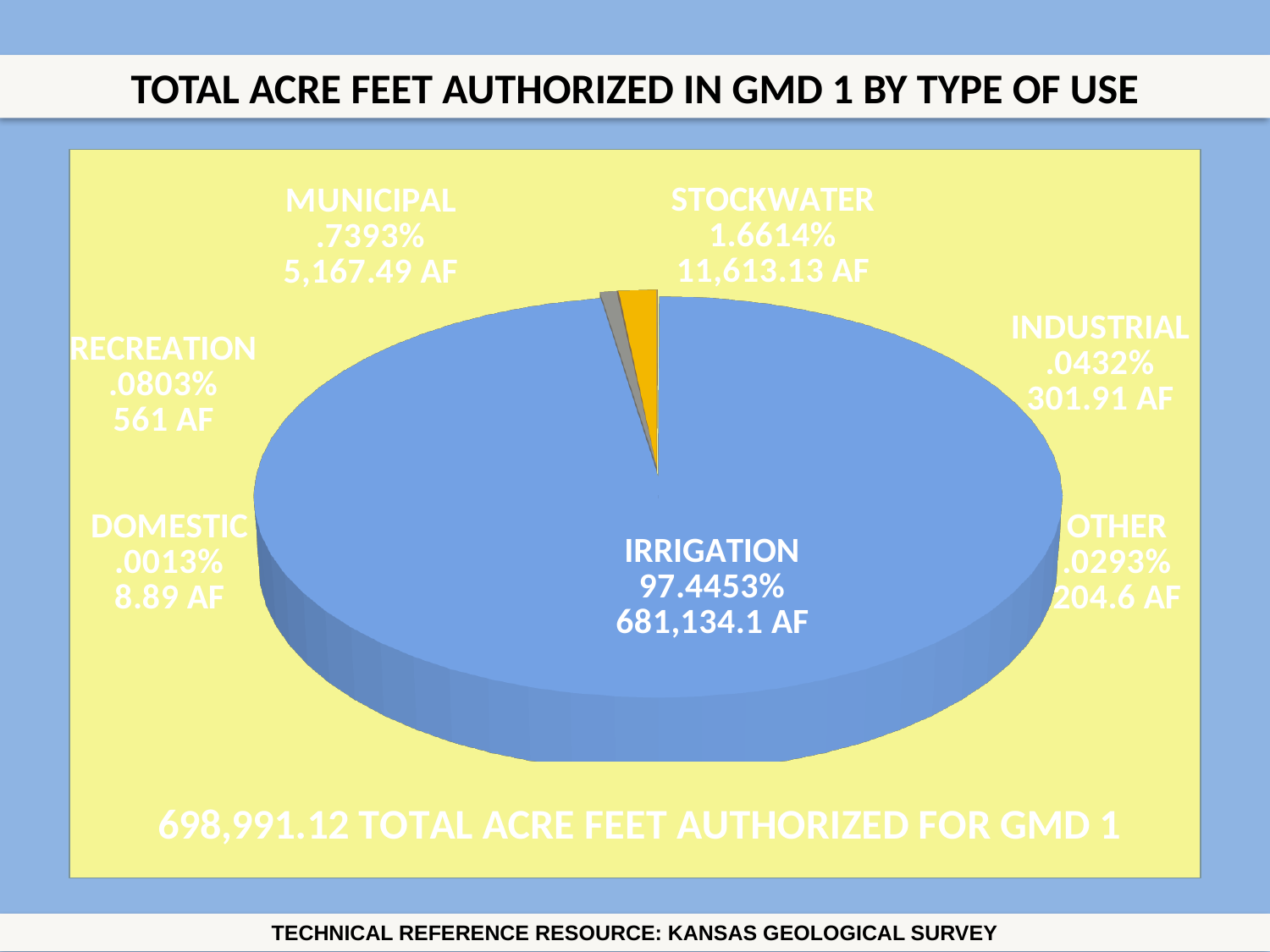
How many acre feet are authorized for irrigation? 681,134.1 AF What kind of chart is shown on the slide? pie chart What share of the pie does stockwater represent? 1.6614% Which type of use has the smallest share of the pie? Domestic How many types of use are shown in the pie chart? 7 What is the total acre feet authorized for GMD 1 according to the slide? 698,991.12 Which type of use has the largest share of the pie? Irrigation What is the difference in acre feet between stockwater and municipal use? 6,445.64 AF What is the title of the chart? TOTAL ACRE FEET AUTHORIZED IN GMD 1 BY TYPE OF USE Which is larger, the acre feet for recreation or for other? Recreation How many acre feet are authorized for municipal use? 5,167.49 AF What percentage of the total is industrial use? .0432%